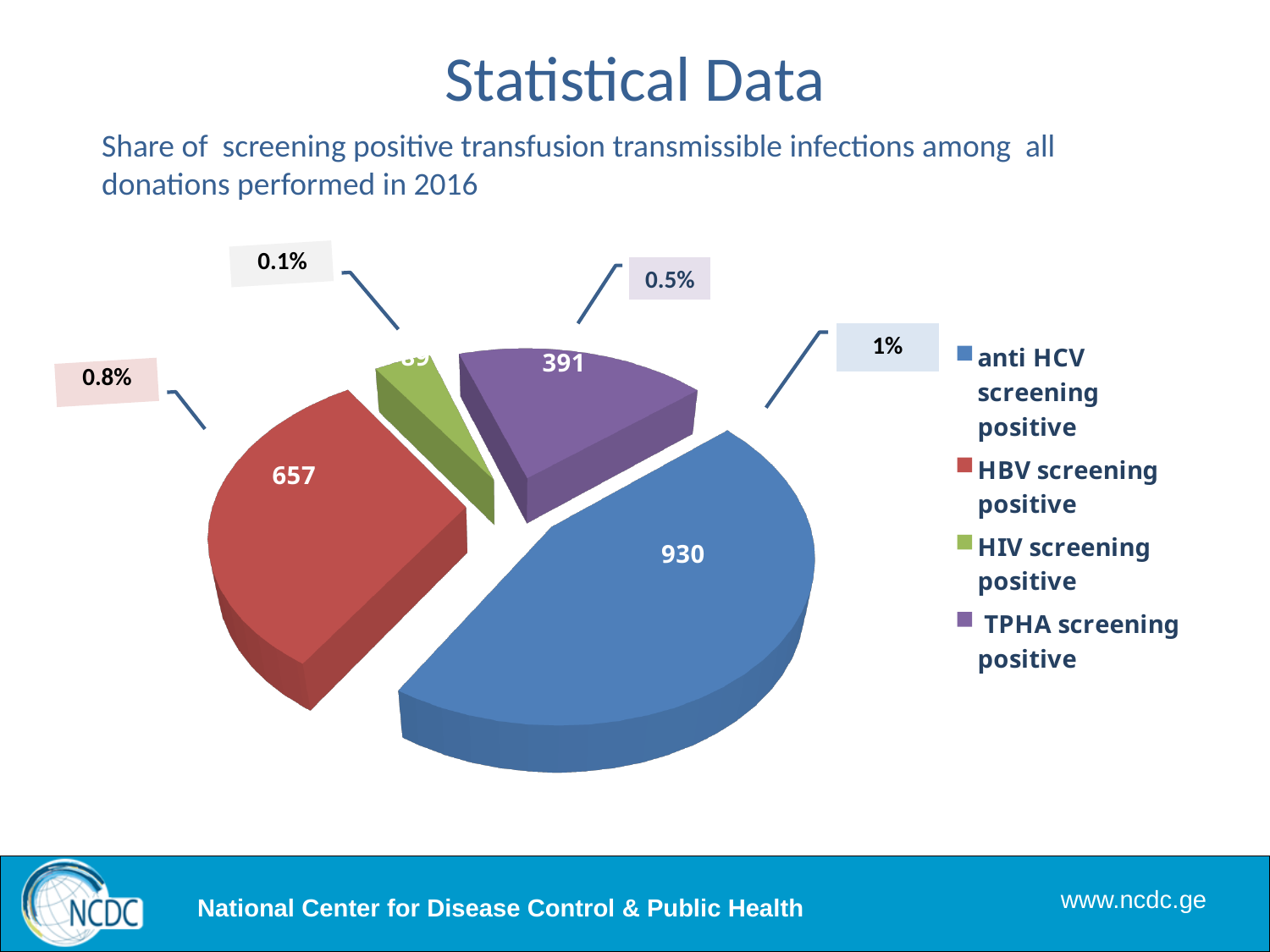
What percentage is shown in the callout pointing to the anti HCV screening positive slice? 1% What is the difference between the anti HCV screening positive value and the HBV screening positive value? 273 What kind of chart is shown on the slide? pie chart What value is shown for the anti HCV screening positive slice? 930 What percentage is shown in the callout pointing to the HBV screening positive slice? 0.8% Which category has the smallest slice of the pie? HIV screening positive Which category has the largest slice of the pie? anti HCV screening positive What value is shown for the HBV screening positive slice? 657 How many categories does the pie chart show? 4 Which is larger, the HBV screening positive value or the TPHA screening positive value? HBV screening positive What value is shown for the TPHA screening positive slice? 391 What is the difference between the HBV screening positive value and the TPHA screening positive value? 266